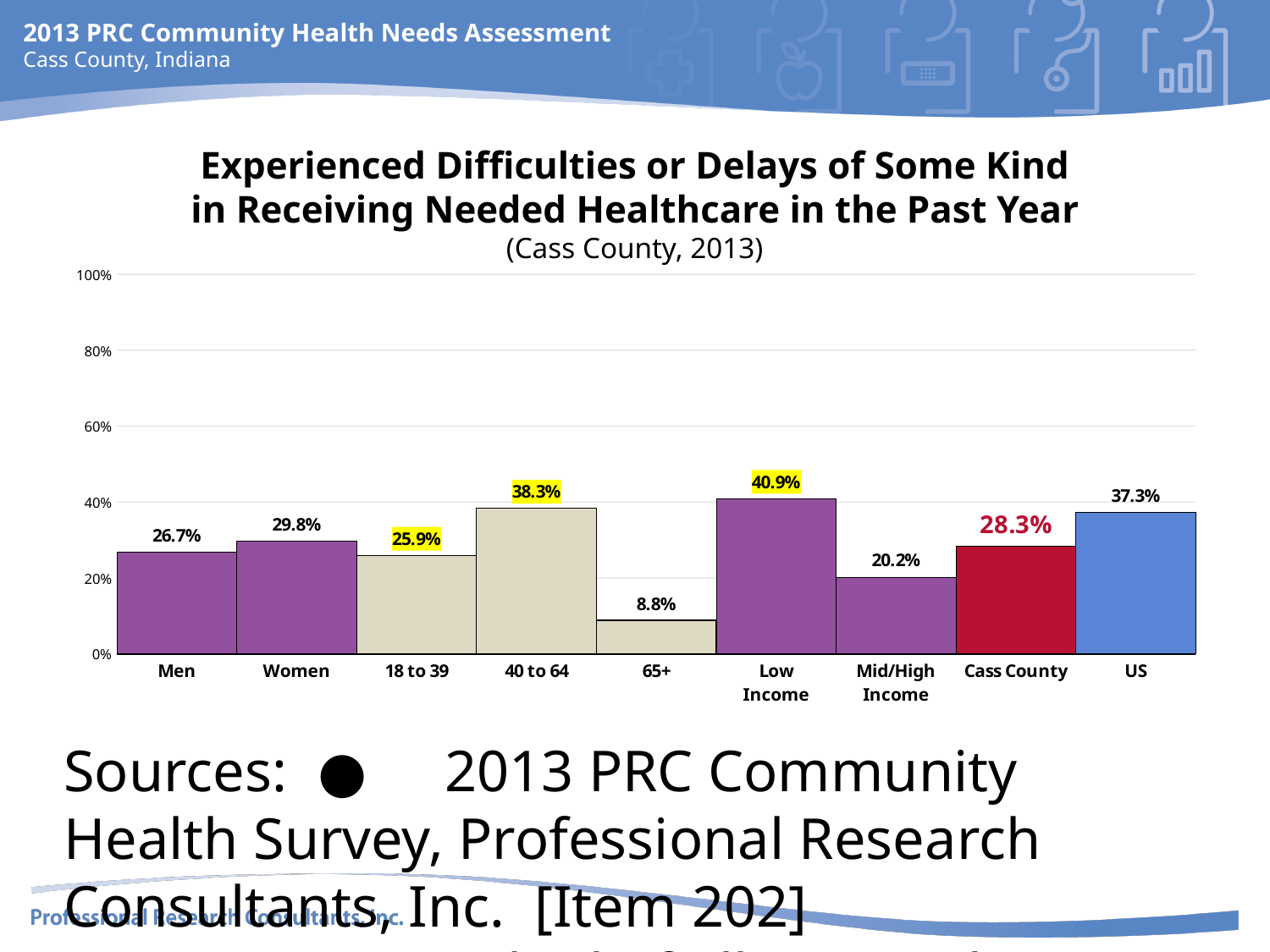
Which category has the highest value? Low Income Is the value for 40 to 64 greater or less than 20%? greater What is the value for Men? 26.7% What is the value for Low Income? 40.9% What is the difference between the US value and the Cass County value? 9.0% Which category has the lowest value? 65+ What is the value for the 65+ age group? 8.8% What kind of chart is this? bar chart Which is larger, the value for Women or the value for Men? Women How many categories are shown on the x axis? 9 What is the subtitle shown under the chart title? (Cass County, 2013) What is the value for Cass County? 28.3%